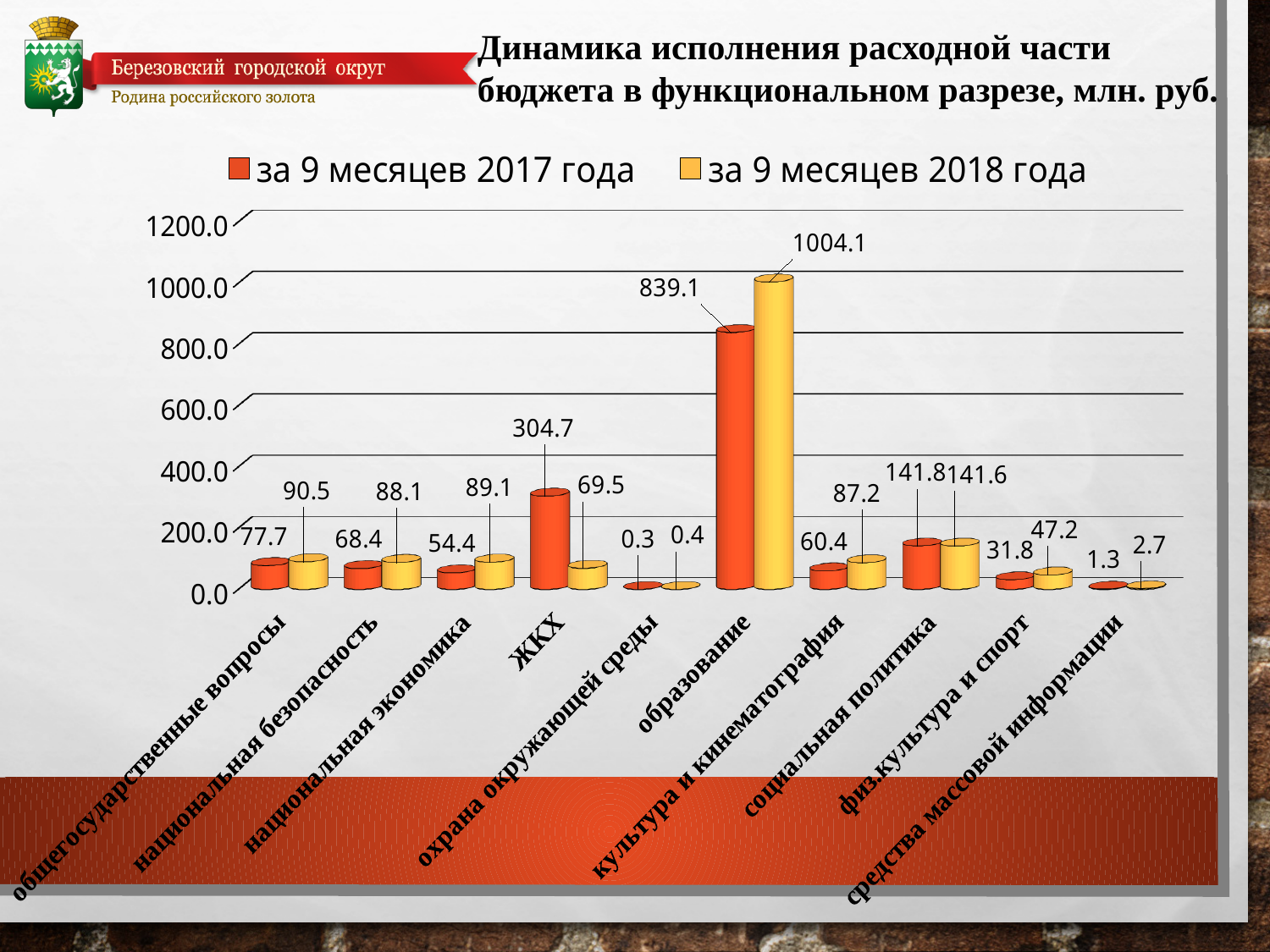
What kind of chart is shown on the slide? bar chart For ЖКХ, which is larger: the value for за 9 месяцев 2017 года or за 9 месяцев 2018 года? за 9 месяцев 2017 года What is the value for ЖКХ for за 9 месяцев 2017 года? 304.7 What is the value for образование for за 9 месяцев 2018 года? 1004.1 What is the difference between the 2017 and 2018 values for ЖКХ? 235.2 How many series does the legend list? 2 What is the value for физ.культура и спорт for за 9 месяцев 2018 года? 47.2 How many categories are shown on the x axis? 10 What is the difference between the 2018 and 2017 values for образование? 165.0 Which category has the highest value for за 9 месяцев 2017 года? образование Is the value for образование for за 9 месяцев 2017 года greater or less than 800.0? greater Which category has the lowest value for за 9 месяцев 2018 года? охрана окружающей среды